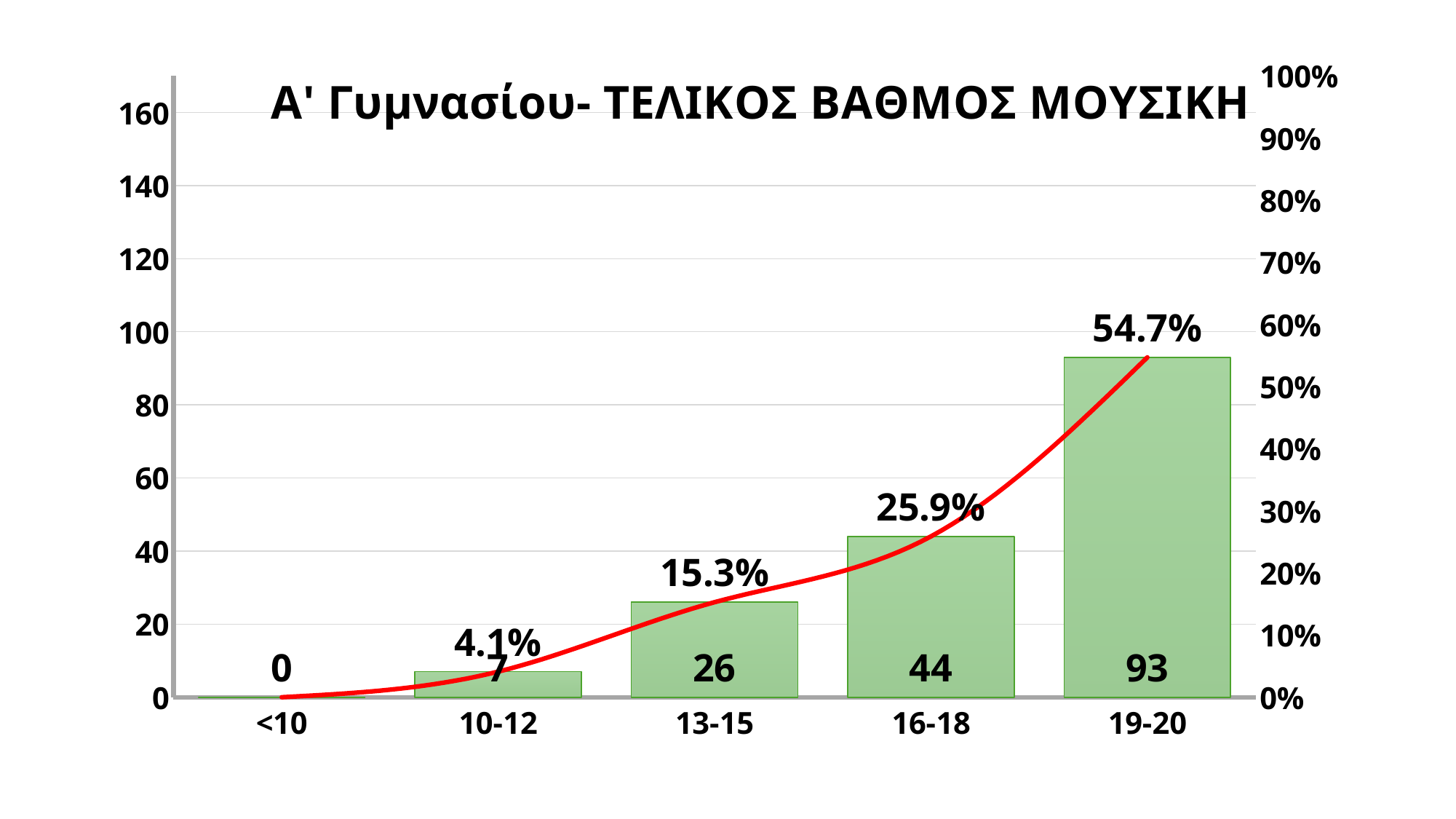
What is the count for the 19-20 grade band? 93 Do the bar values rise or fall from left to right along the x axis? rise Which grade band has the highest count? 19-20 What is the difference between the counts for 19-20 and 16-18? 49 Which grade band has the lowest count? <10 Which has a larger count, 13-15 or 16-18? 16-18 How many grade bands are shown on the x axis? 5 What is the count for the 13-15 grade band? 26 What is the title of the chart? Α' Γυμνασίου- ΤΕΛΙΚΟΣ ΒΑΘΜΟΣ ΜΟΥΣΙΚΗ Is the count for 19-20 greater or less than 100? less What percentage is shown for the 10-12 grade band? 4.1% What percentage is shown for the 16-18 grade band? 25.9%